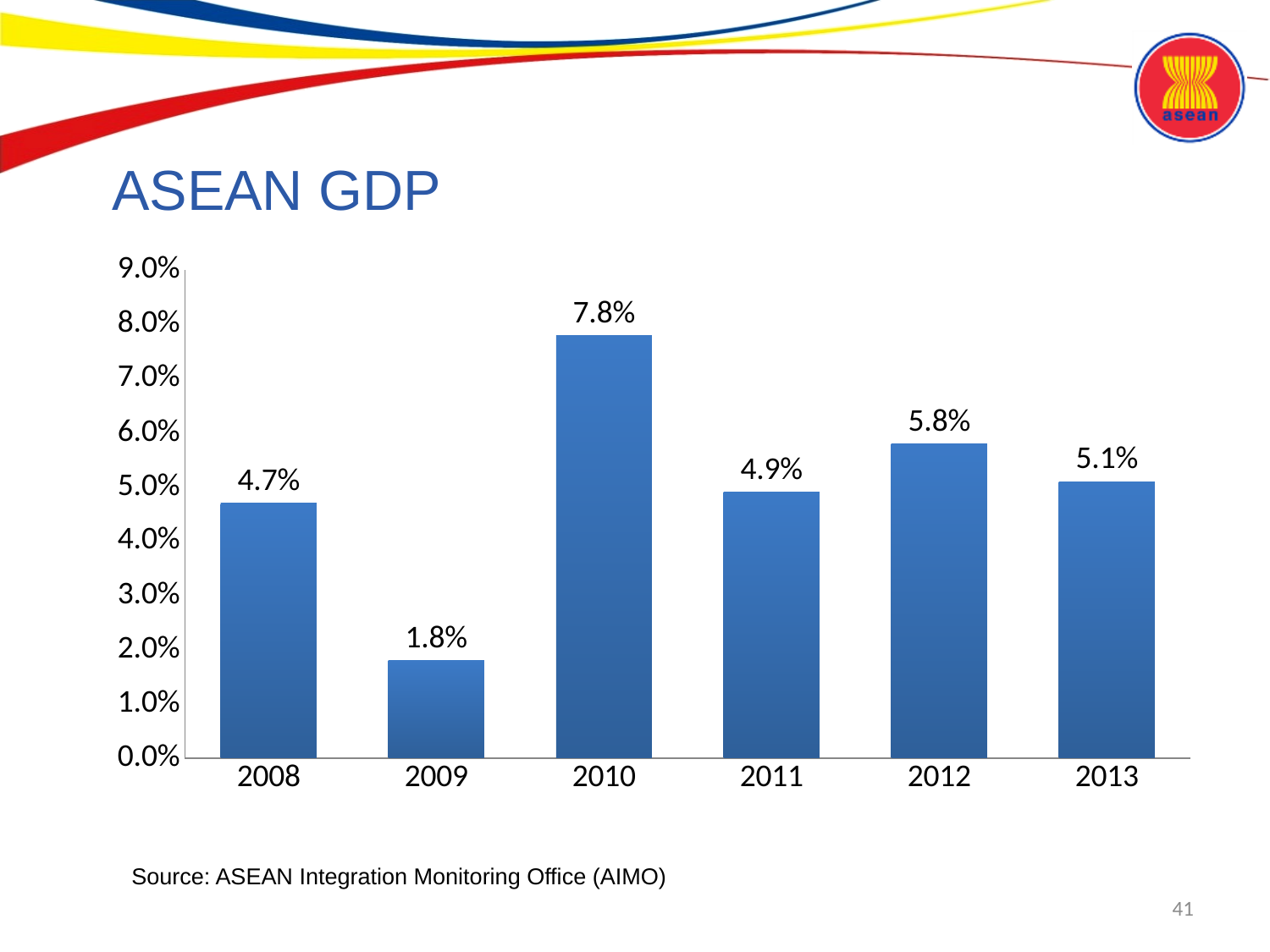
What is the difference between the values for 2012 and 2013? 0.7% How many years are shown on the x axis of the chart? 6 Is the value for 2013 greater or less than 6.0%? less What kind of chart is shown on the slide? bar chart Which year has the highest value in the chart? 2010 What is the value shown for 2012? 5.8% What is the title of the chart on the slide? ASEAN GDP Which year has a larger value, 2008 or 2011? 2011 Which year has the lowest value in the chart? 2009 What is the value shown for 2009? 1.8% What is the difference between the values for 2010 and 2009? 6.0% What is the ASEAN GDP growth value shown for 2010? 7.8%